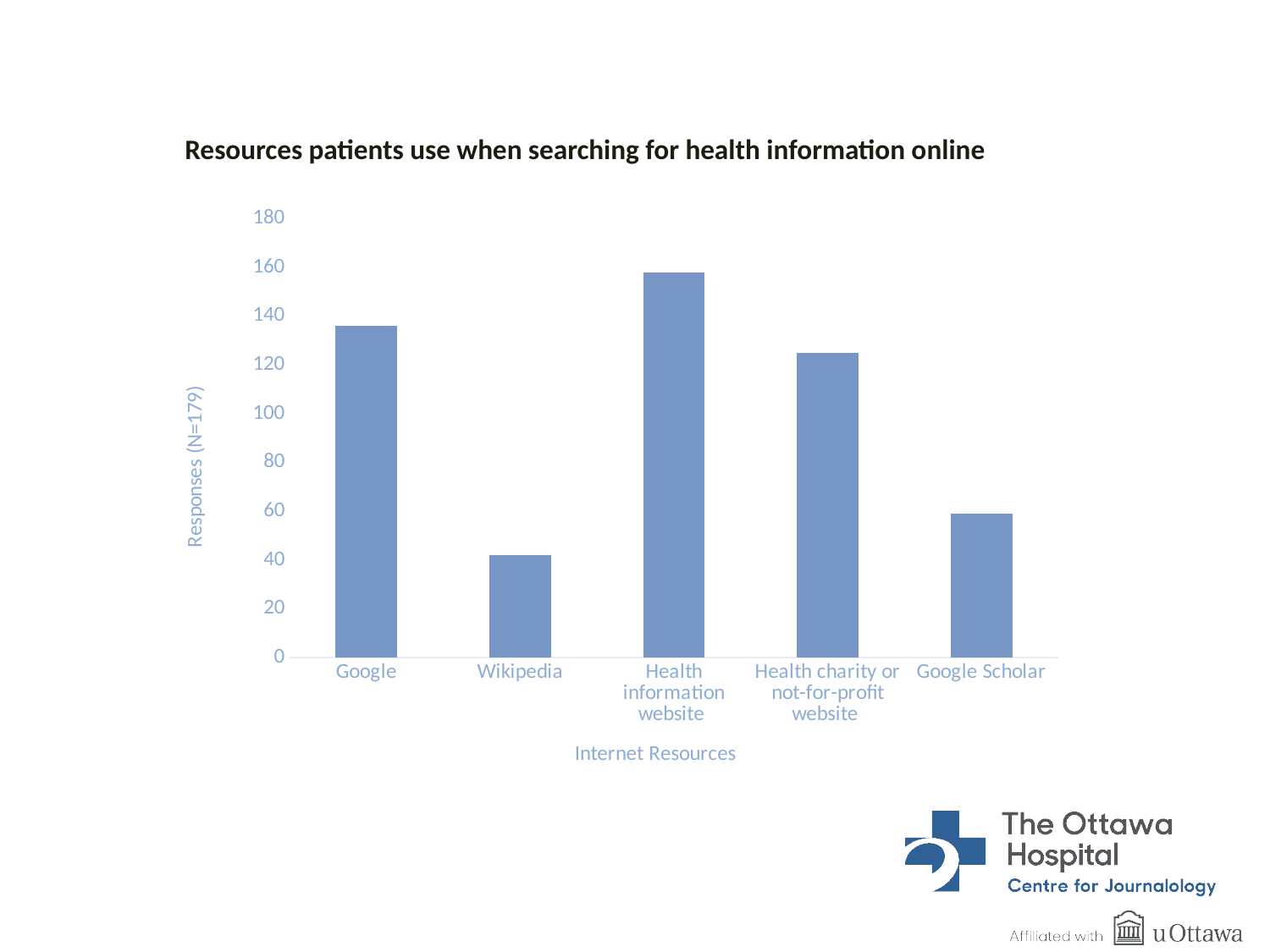
What kind of chart is shown on the slide? bar chart Which internet resource has the lowest number of responses? Wikipedia Is the value for Health charity or not-for-profit website greater or less than 100? greater Is the value for Google Scholar greater or less than 80? less What is the title of the chart? Resources patients use when searching for health information online Which internet resource has the highest number of responses? Health information website Which has more responses, Google Scholar or Wikipedia? Google Scholar Is the value for Google greater or less than 120? greater How many internet resources (categories) are plotted on the chart? 5 Which has more responses, Google or Health charity or not-for-profit website? Google